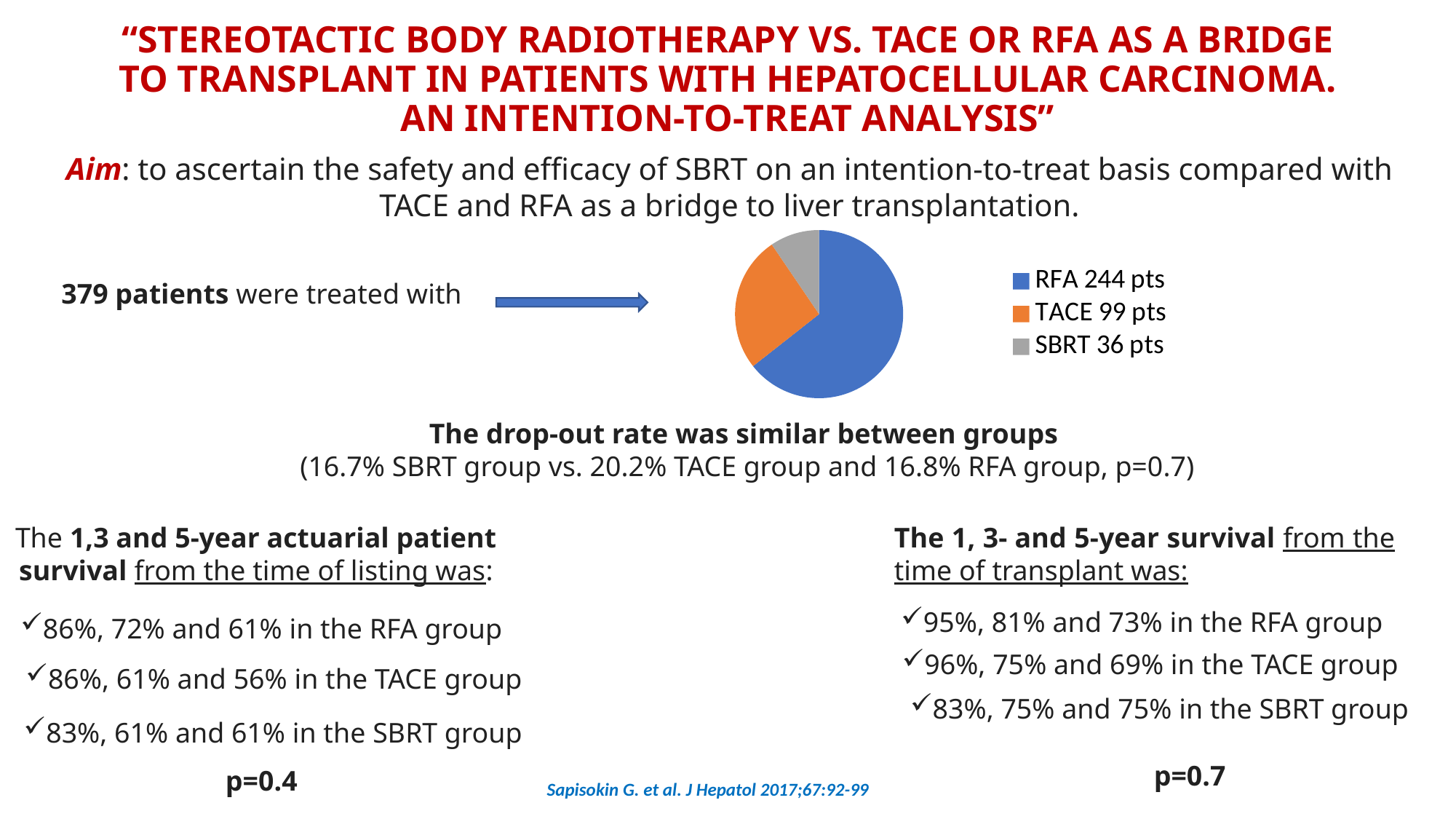
Which treatment group has the smallest slice of the pie chart? SBRT What colour represents the TACE group in the pie chart? Orange How many patients were treated with TACE according to the pie chart legend? 99 pts What type of chart is shown on the slide? Pie chart How many more patients were treated with TACE than with SBRT? 63 How many patients were treated with RFA according to the pie chart legend? 244 pts Which group had more patients, TACE or SBRT? TACE How many categories does the pie chart show? 3 How many more patients were treated with RFA than with TACE? 145 Which treatment group has the largest slice of the pie chart? RFA What is the total number of patients represented in the pie chart? 379 How many patients were treated with SBRT according to the pie chart legend? 36 pts